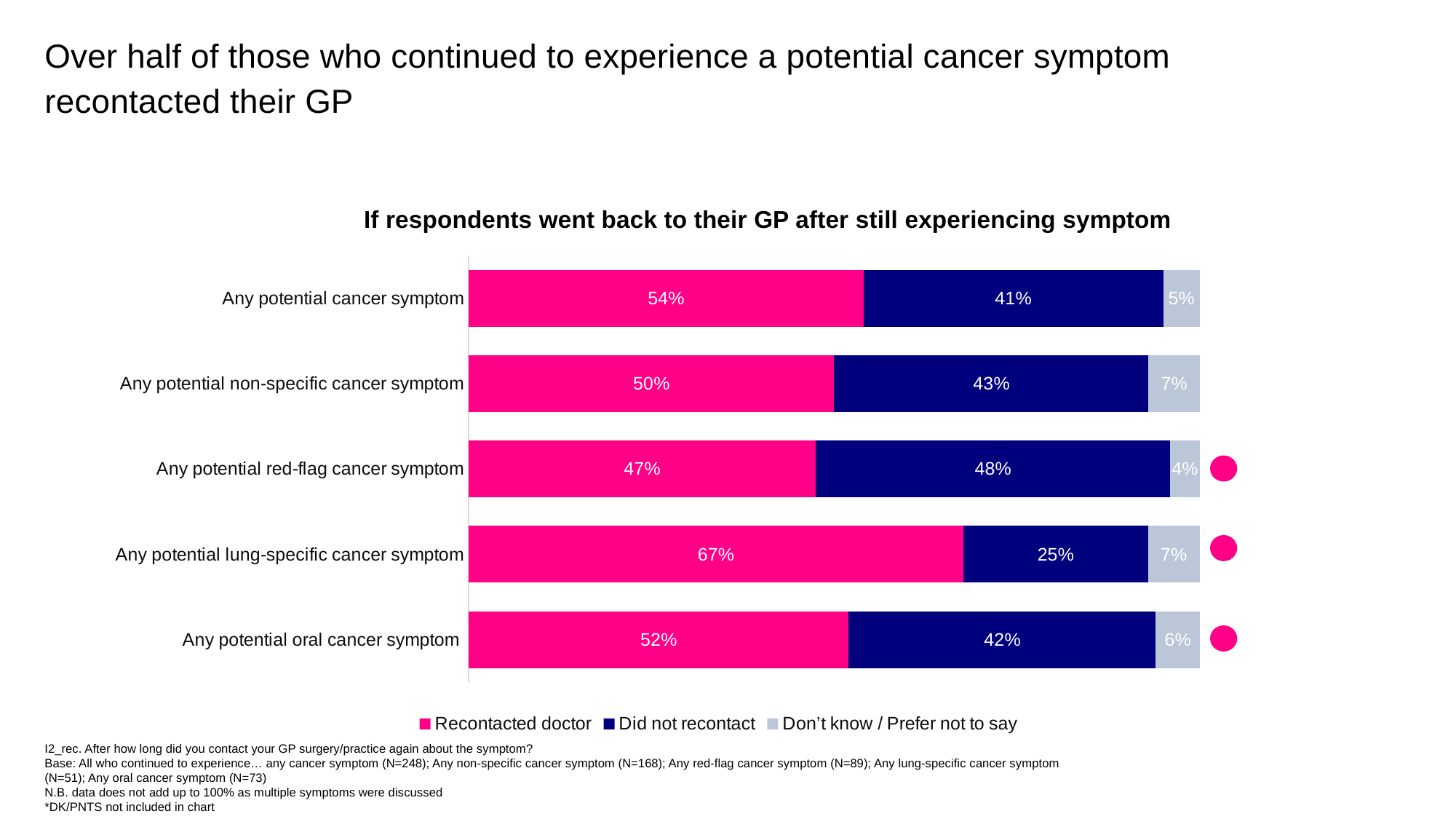
What is the title of the chart? If respondents went back to their GP after still experiencing symptom Which is larger for any potential red-flag cancer symptom: 'Recontacted doctor' or 'Did not recontact'? Did not recontact What type of chart is shown on the slide? Stacked bar chart What is the 'Did not recontact' value for any potential red-flag cancer symptom? 48% Which symptom category has the highest 'Recontacted doctor' percentage? Any potential lung-specific cancer symptom Which symptom category has the lowest 'Did not recontact' percentage? Any potential lung-specific cancer symptom What is the 'Don't know / Prefer not to say' value for any potential oral cancer symptom? 6% How many series does the legend list? 3 What is the total of the stacked bar for any potential non-specific cancer symptom? 100% What percentage of respondents with any potential lung-specific cancer symptom recontacted their doctor? 67% What is the difference between the 'Recontacted doctor' and 'Did not recontact' values for any potential cancer symptom? 13 percentage points How many symptom categories are shown in the chart? 5